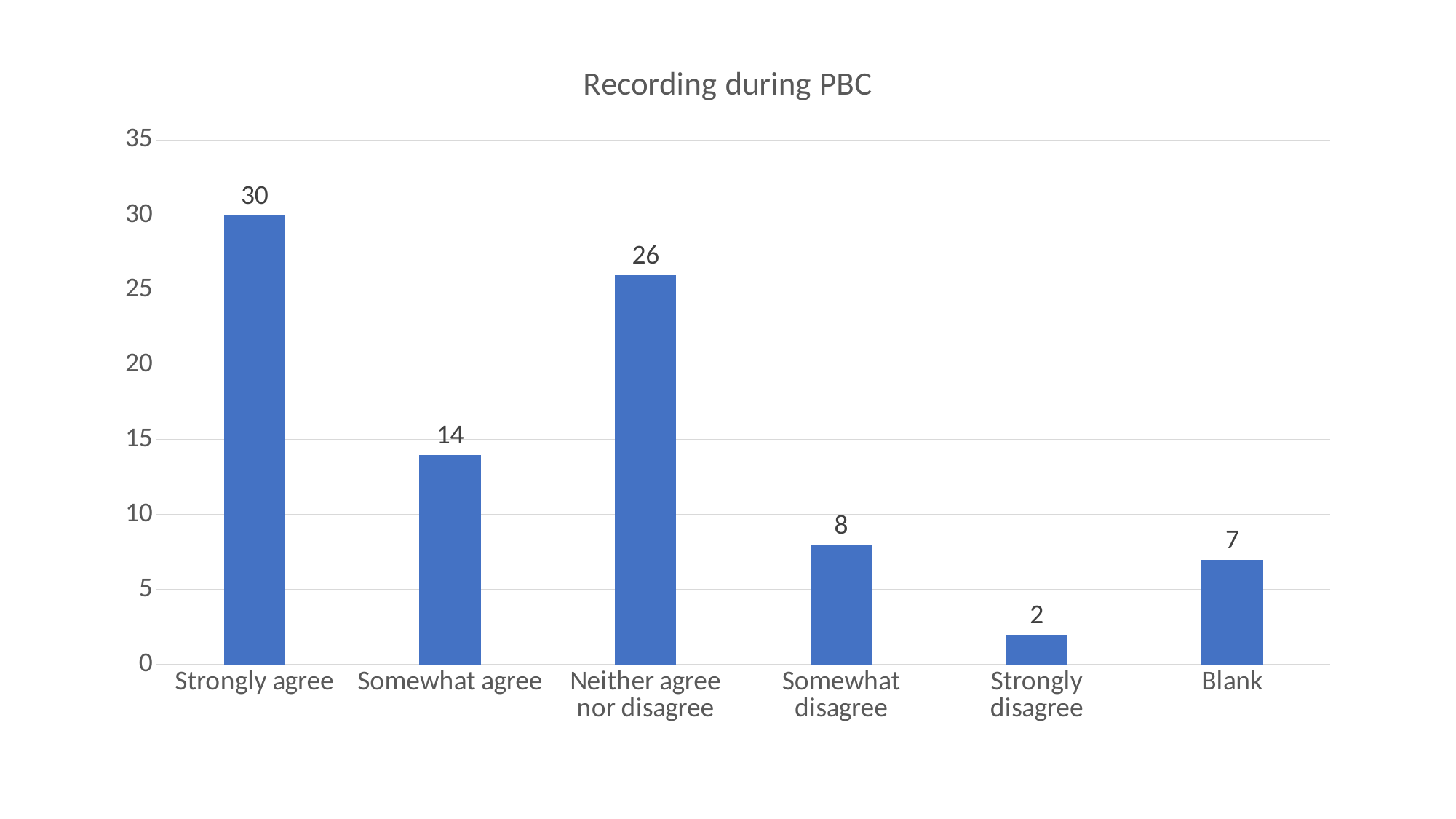
What is the value for Strongly agree? 30 Which category has the highest value? Strongly agree What is the value for Neither agree nor disagree? 26 Which category has the lowest value? Strongly disagree How many categories are shown on the x axis? 6 What is the difference between the values for Somewhat disagree and Strongly disagree? 6 What is the difference between the values for Strongly agree and Somewhat agree? 16 What is the value for Blank? 7 What kind of chart is shown on the slide? bar chart Which is larger, the value for Somewhat agree or the value for Neither agree nor disagree? Neither agree nor disagree What is the title of the chart? Recording during PBC Is the value for Somewhat agree greater or less than 10? greater